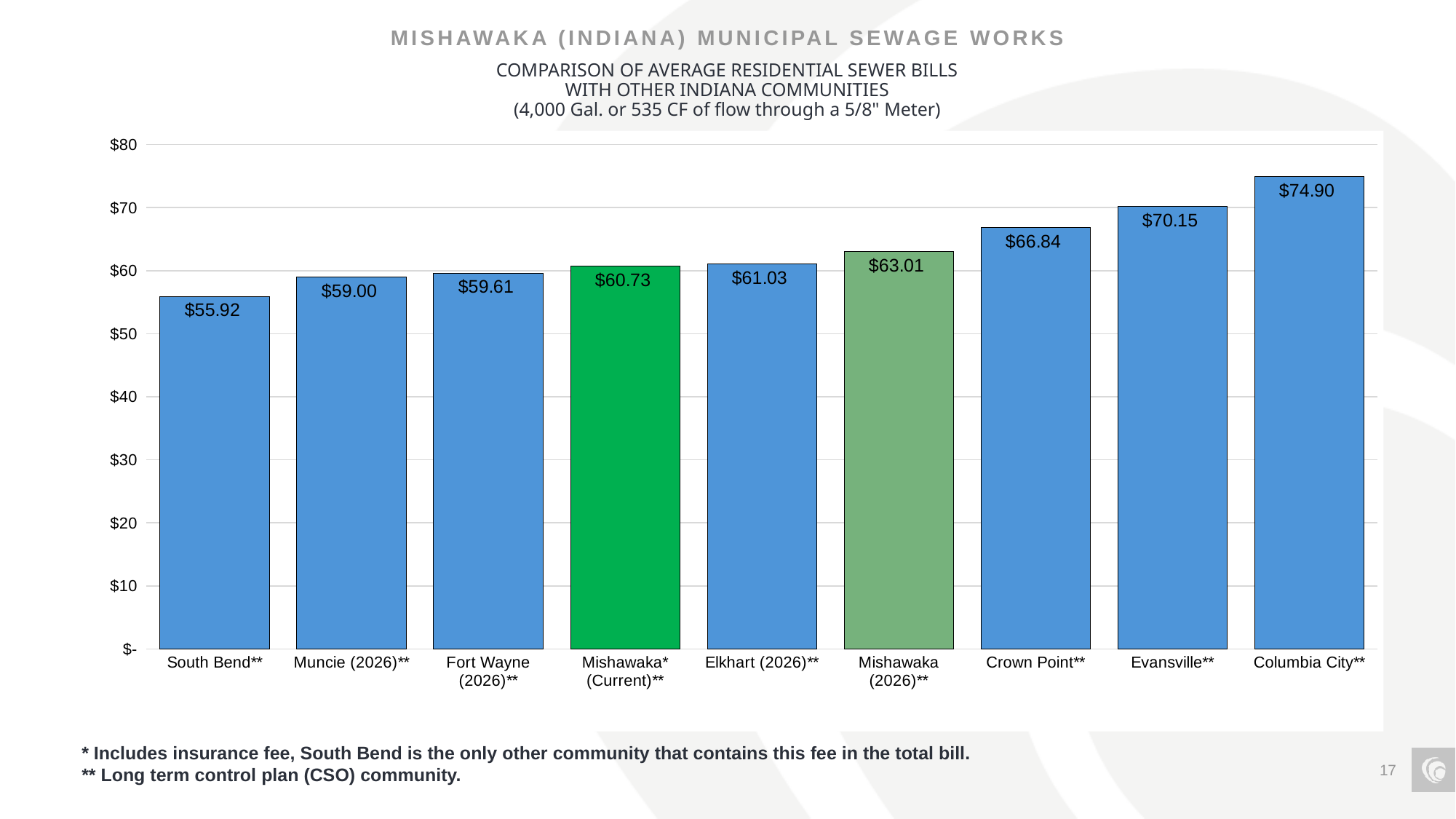
Which is larger, the bill for Crown Point** or the bill for Elkhart (2026)**? Crown Point** Which community has the lowest average residential sewer bill on the chart? South Bend** What is the difference between the Columbia City** bill and the South Bend** bill? $18.98 What is the value shown for Mishawaka* (Current)**? $60.73 What kind of chart is shown on the slide? Bar chart What is the average residential sewer bill shown for South Bend**? $55.92 What is the difference between the Mishawaka (2026)** bill and the Mishawaka* (Current)** bill? $2.28 What is the value shown for Mishawaka (2026)**? $63.01 How many communities (bars) are shown on the chart? 9 What is the value shown for Evansville**? $70.15 Do the values rise or fall moving from left to right along the x axis? Rise Which community has the highest average residential sewer bill on the chart? Columbia City**